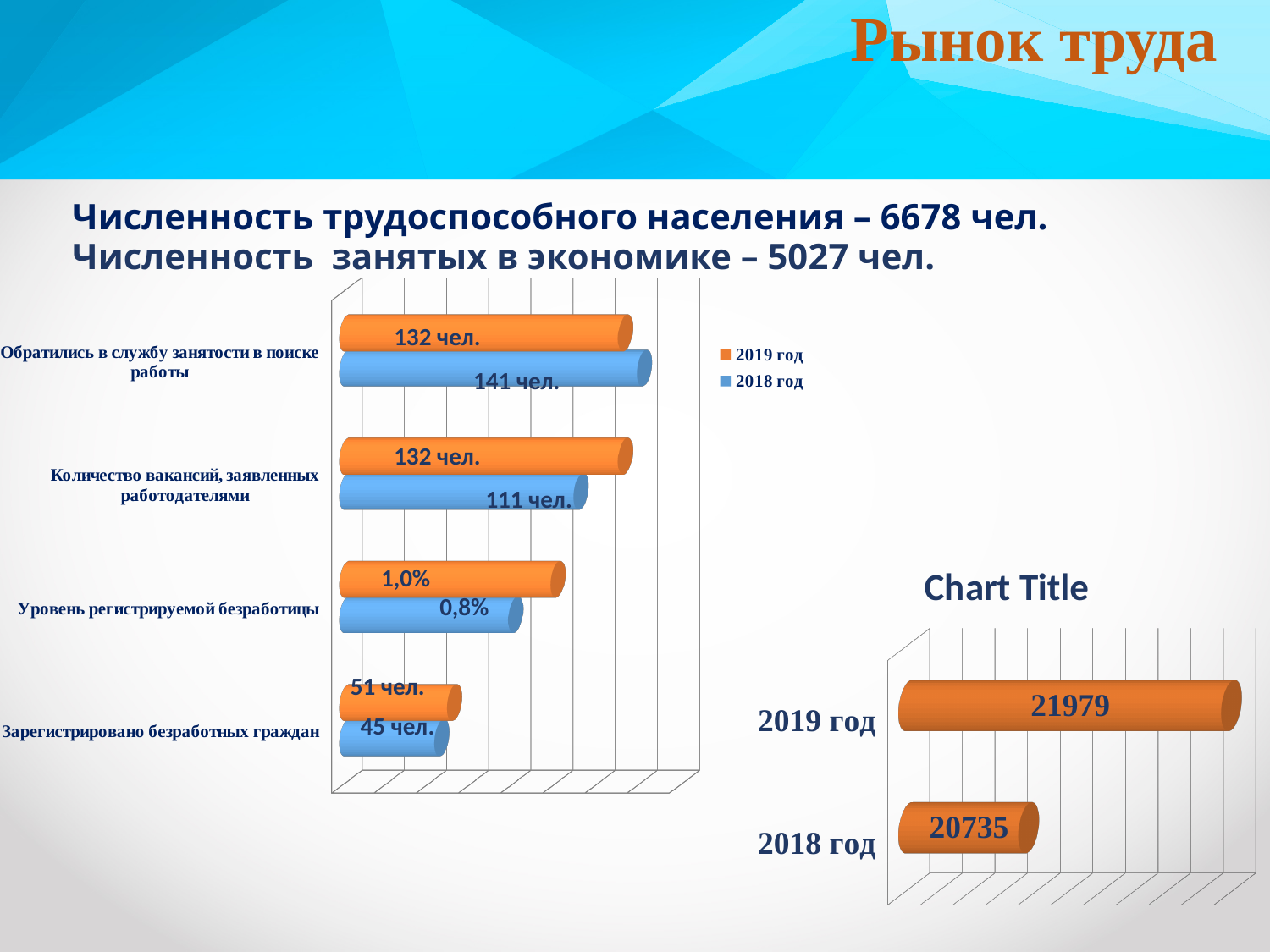
How many categories are shown in the left chart? 4 In the left chart, which year has the larger value for 'Обратились в службу занятости в поиске работы', 2019 год or 2018 год? 2018 год In the chart titled 'Chart Title', what is the value for 2019 год? 21979 In the left chart, what is the 2018 год value for 'Обратились в службу занятости в поиске работы'? 141 чел. What kind of chart is the chart titled 'Chart Title'? Bar chart In the left chart, what is the 2019 год value for 'Обратились в службу занятости в поиске работы'? 132 чел. In the left chart, what is the difference between the 2019 год and 2018 год values for 'Количество вакансий, заявленных работодателями'? 21 чел. How many series does the legend of the left chart list? 2 In the chart titled 'Chart Title', what is the difference between the 2019 год and 2018 год values? 1244 In the left chart, what is the 2018 год value for 'Количество вакансий, заявленных работодателями'? 111 чел. In the left chart, what is the 2019 год value for 'Уровень регистрируемой безработицы'? 1,0% In the left chart, what is the 2018 год value for 'Зарегистрировано безработных граждан'? 45 чел.